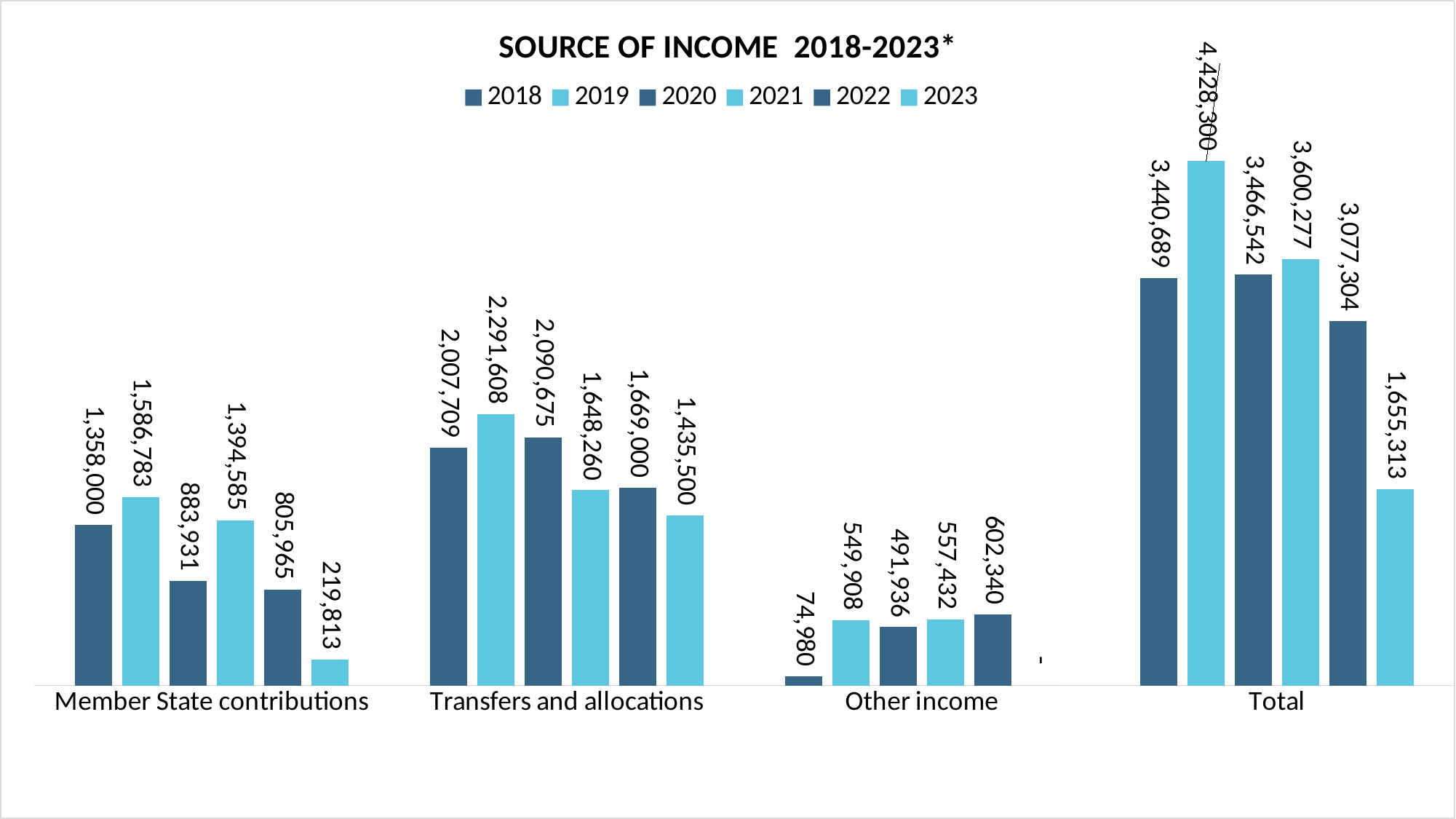
What is the difference between the Transfers and allocations values for 2018 and 2023? 572,209 Which is larger, Member State contributions in 2021 or Member State contributions in 2020? 2021 What is the title of the chart? SOURCE OF INCOME 2018-2023* What is the value for Member State contributions in 2018? 1,358,000 Which year has the highest Total value? 2019 What kind of chart is shown on the slide? bar chart What is the Total value for 2023? 1,655,313 How many series does the legend list? 6 What is the value for Other income in 2022? 602,340 What is the value for Transfers and allocations in 2019? 2,291,608 How many categories are shown on the x axis? 4 Which year has the lowest value for Member State contributions? 2023